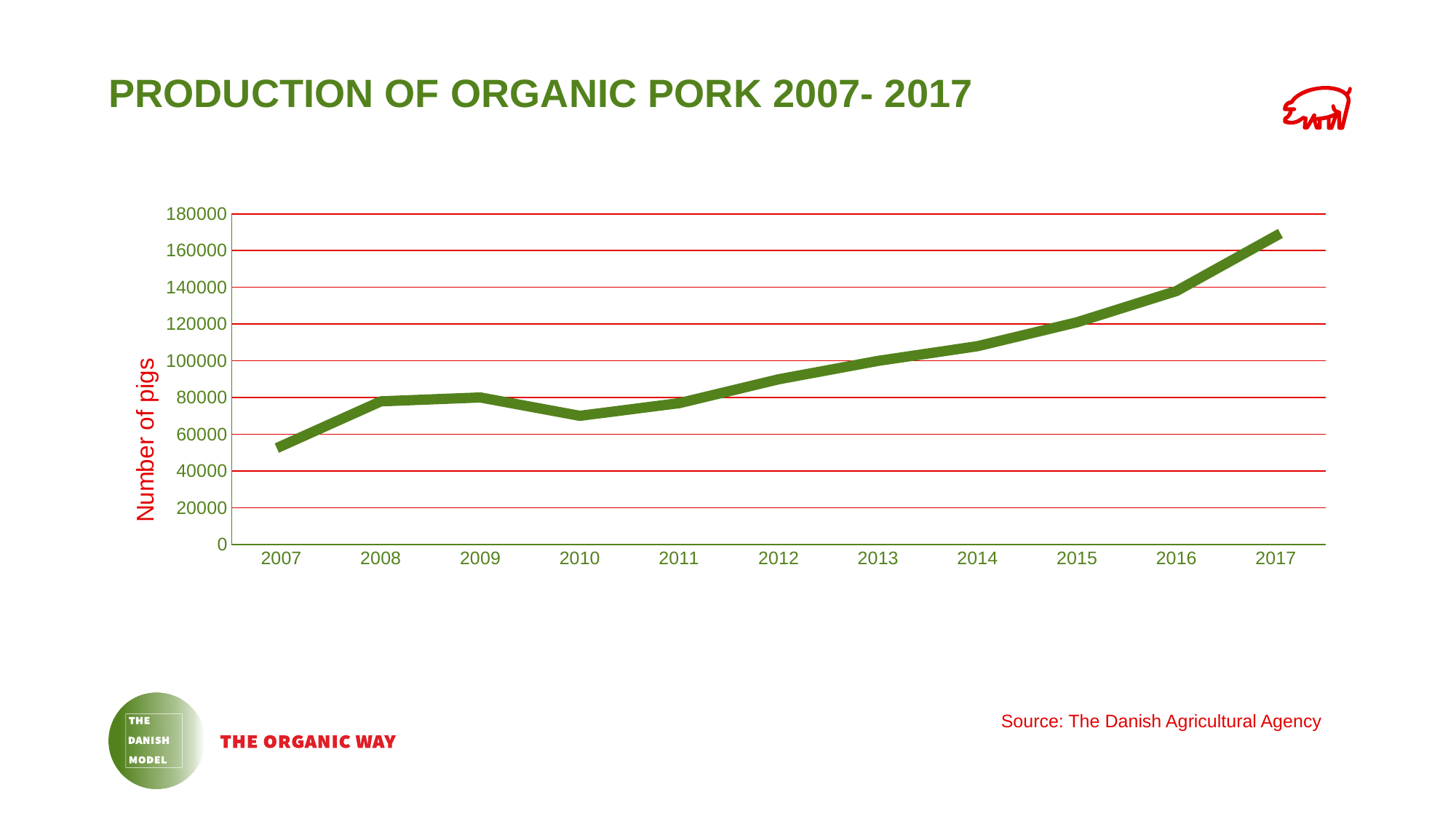
Does the number of pigs generally rise or fall from 2007 to 2017? rise Is the value for 2017 greater or less than 160000? greater Is the value for 2007 greater or less than 60000? less Is the value for 2015 greater or less than 100000? greater What is the title of the chart? PRODUCTION OF ORGANIC PORK 2007- 2017 How many years are plotted on the x axis? 11 Which year has the lowest number of pigs? 2007 What kind of chart is shown on the slide? line chart Which year has the highest number of pigs? 2017 Which year has a larger value, 2009 or 2010? 2009 What is the label on the vertical axis? Number of pigs